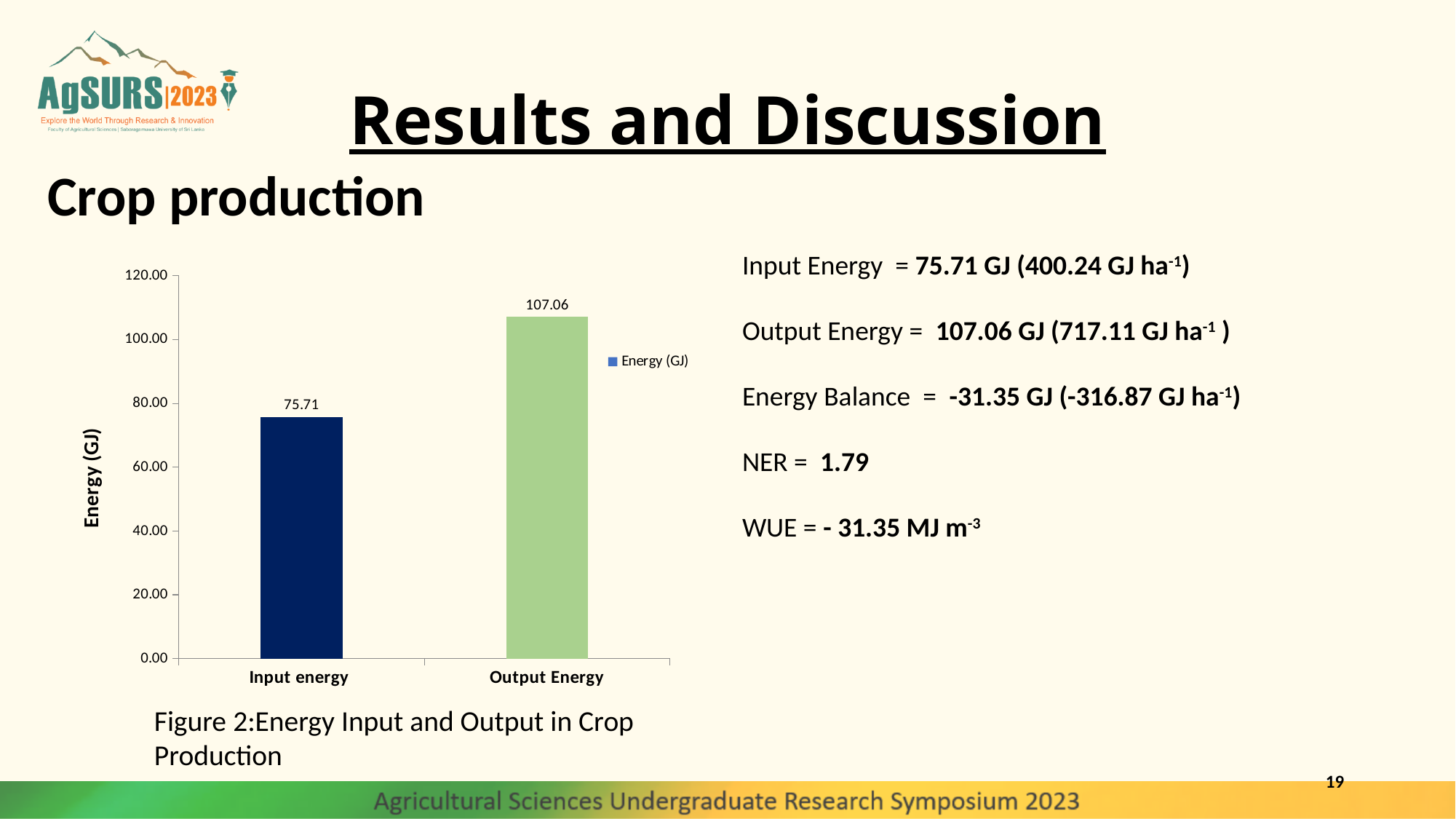
What is the difference between the Output Energy and Input energy values in the chart? 31.35 Which category has the lowest value in the chart? Input energy Which category has the highest value in the chart? Output Energy How many series does the chart legend list? 1 How many categories are shown on the x axis of the chart? 2 What kind of chart is shown on the slide? Bar chart What is the label on the y axis of the chart? Energy (GJ) Which is larger in the chart, Input energy or Output Energy? Output Energy What is the value for Input energy in the chart? 75.71 Is the value for Input energy greater or less than 80.00? less Is the value for Output Energy greater or less than 100.00? greater What is the value for Output Energy in the chart? 107.06